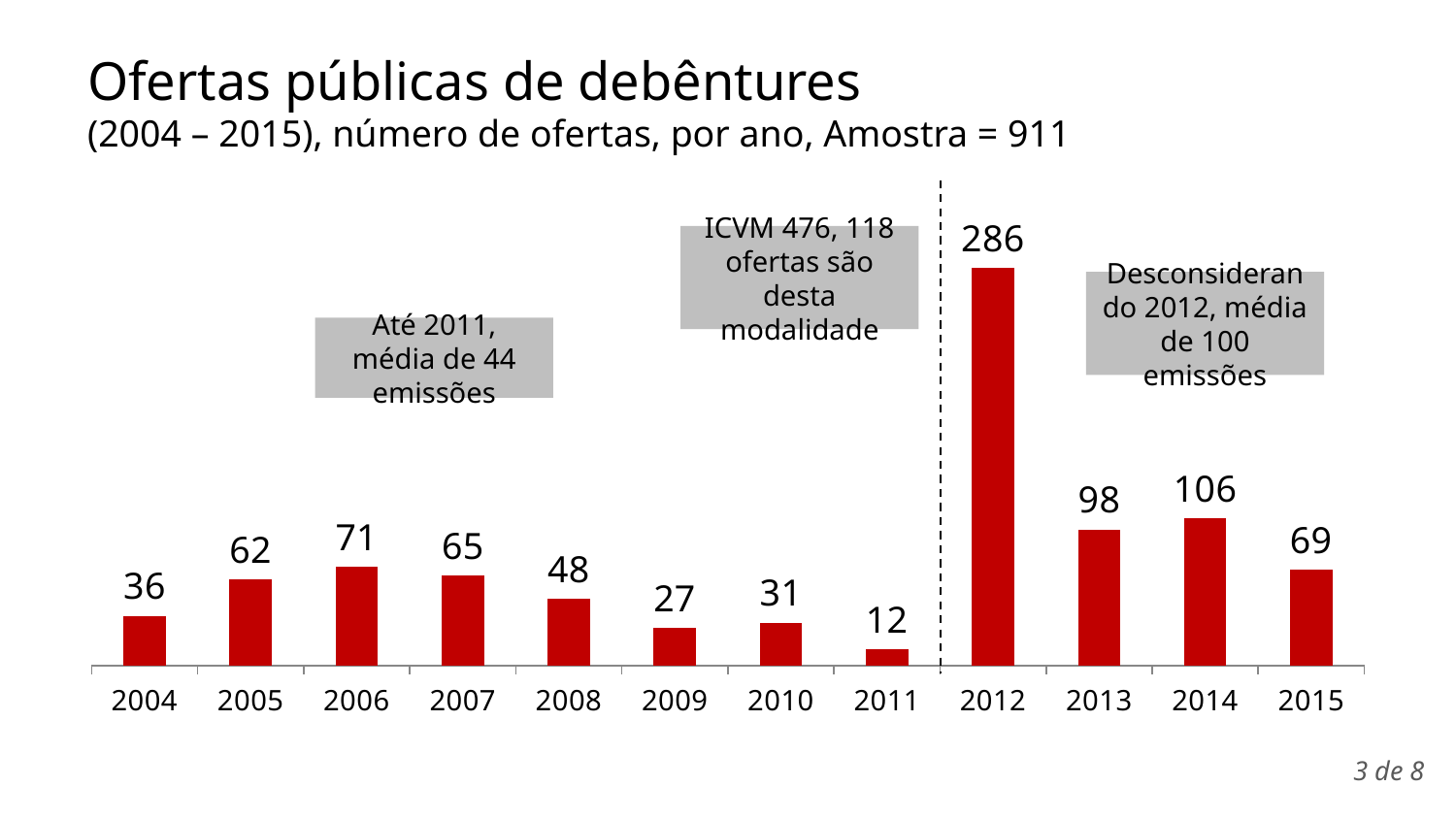
What is the difference between the number of offers in 2014 and 2013? 8 What kind of chart is shown on the slide? Bar chart What is the number of offers for 2012? 286 How many years are shown on the x axis? 12 What is the number of offers for 2006? 71 What is the difference between the number of offers in 2012 and 2015? 217 Which year has more offers, 2005 or 2007? 2007 Do the values rise or fall from 2006 to 2011? Fall Which year has more offers, 2009 or 2010? 2010 Which year has the highest number of offers? 2012 Which year has the lowest number of offers? 2011 What is the number of offers for 2011? 12